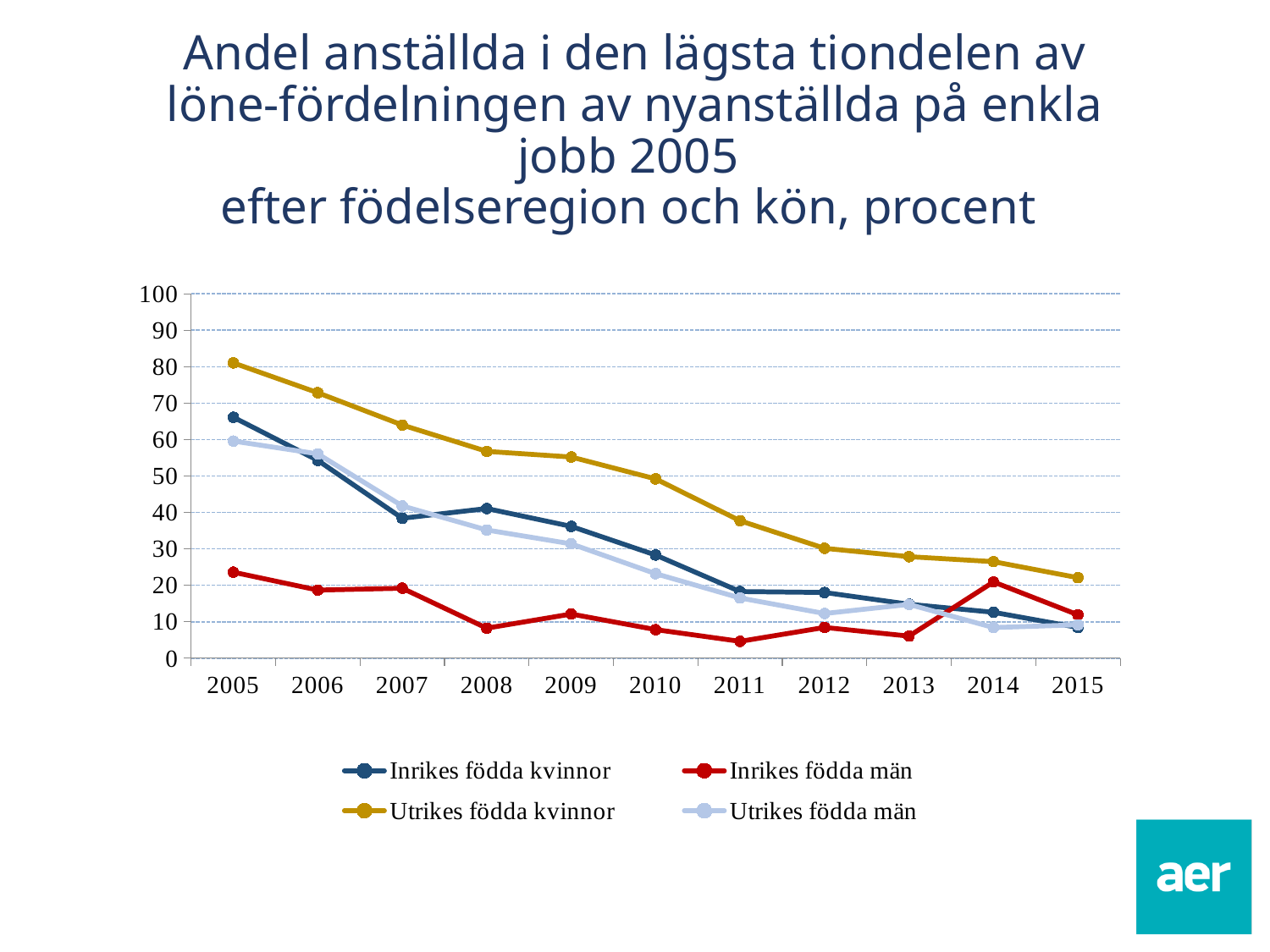
In 2014, which is larger: Inrikes födda män or Utrikes födda män? Inrikes födda män Is the value for Inrikes födda män in 2011 greater or less than 10? less What kind of chart is shown on the slide? line chart Which series has the highest value in 2005? Utrikes födda kvinnor Does the Utrikes födda kvinnor series rise or fall from 2005 to 2015? fall Which series has the lowest value in 2005? Inrikes födda män Is the value for Utrikes födda kvinnor in 2010 greater or less than 60? less How many series does the legend list? 4 Is the value for Utrikes födda kvinnor in 2005 greater or less than 70? greater How many years are shown along the x axis? 11 What colour is the line for Utrikes födda kvinnor? gold/yellow Which series has the highest value in 2015? Utrikes födda kvinnor